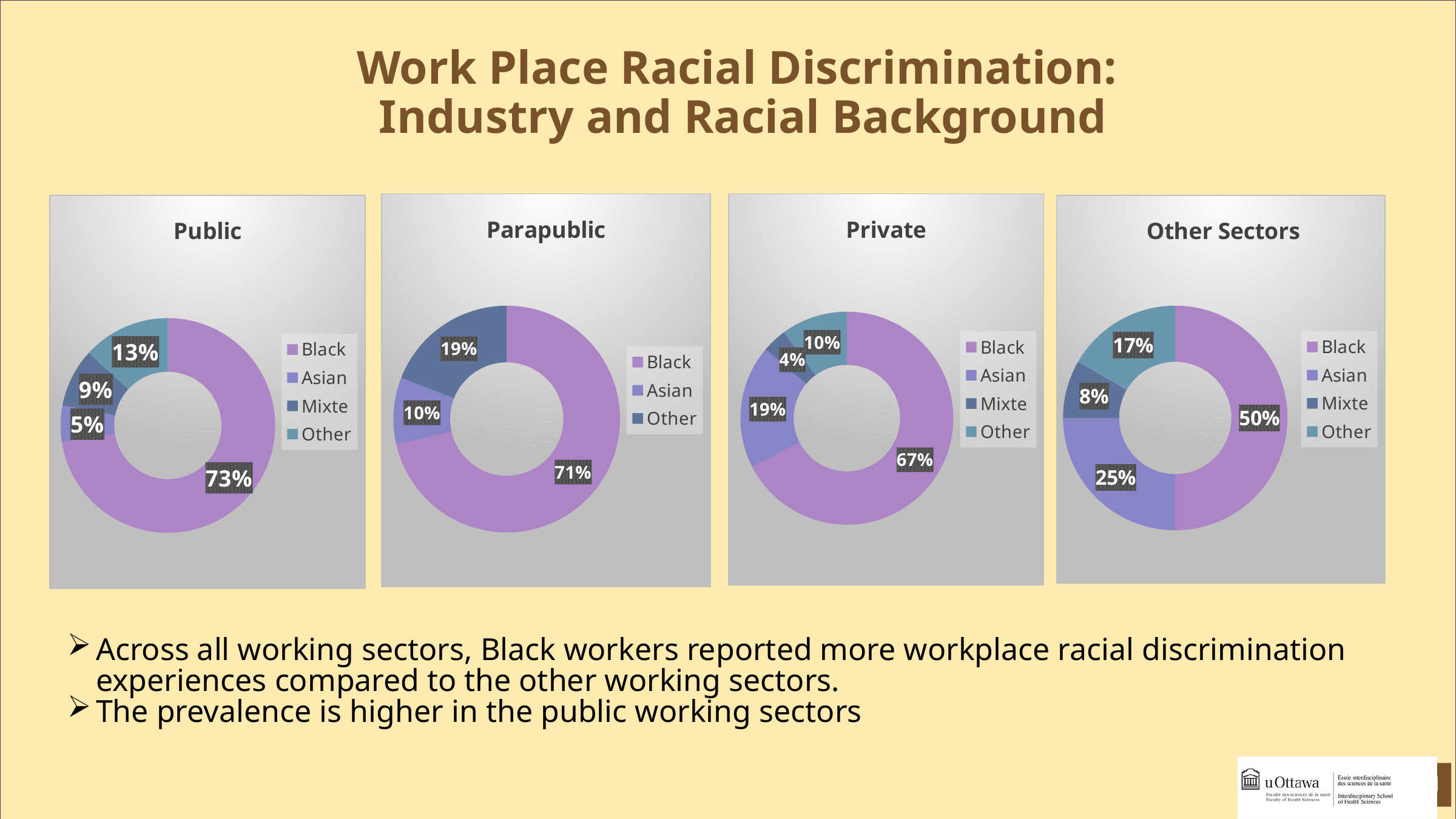
In the Other Sectors chart, what percentage is shown for Asian? 25% In the Other Sectors chart, what is the difference between the Black share and the Asian share? 25% How many charts are shown on the slide? 4 In the Public chart, which category has the smallest share? Asian In the Private chart, what percentage is shown for Mixte? 4% How many slices does the Private chart have? 4 In the Private chart, which category has the largest share? Black What kind of chart is the Other Sectors chart? Donut (pie) chart In the Public chart, which is larger, the share for Mixte or the share for Other? Other How many series does the legend of the Parapublic chart list? 3 In the Public chart, what percentage is shown for Black? 73% In the Parapublic chart, what percentage is shown for Other? 19%